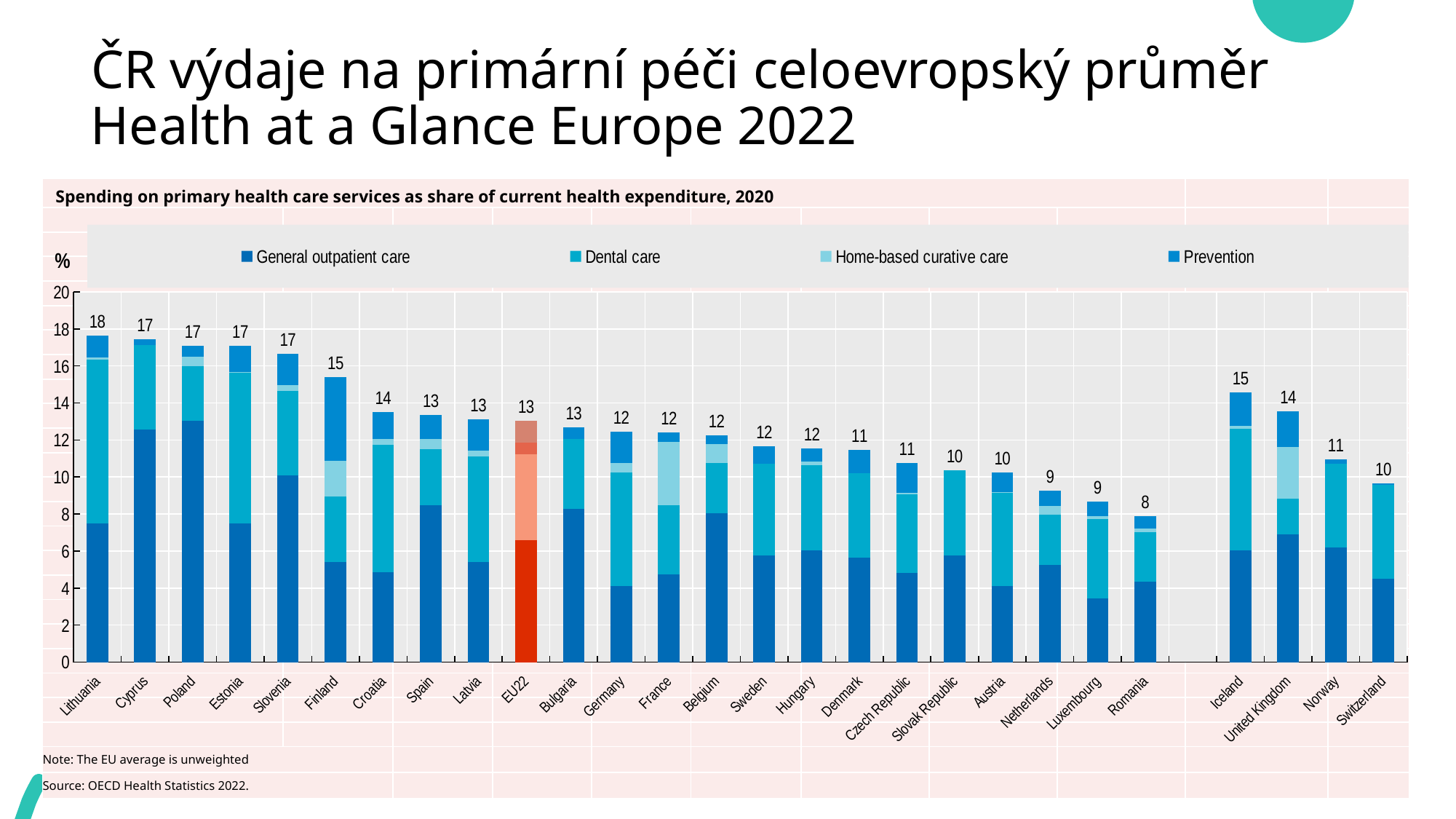
Which country has the highest total share of spending on primary health care? Lithuania What type of chart is shown on the slide? stacked bar chart What is the total spending on primary health care as a share of current health expenditure for the Czech Republic? 11 What is the total value shown for Iceland? 15 Which country has the lowest total share of spending on primary health care? Romania How many countries/regions are shown on the x axis? 27 What is the difference between the total for Lithuania and the total for Romania? 10 What is the total value shown for EU22? 13 Is the General outpatient care value for Cyprus greater or less than 10? greater How many series does the legend list? 4 Which has a larger total, Finland or the Czech Republic? Finland Is the General outpatient care value for Switzerland greater or less than 6? less